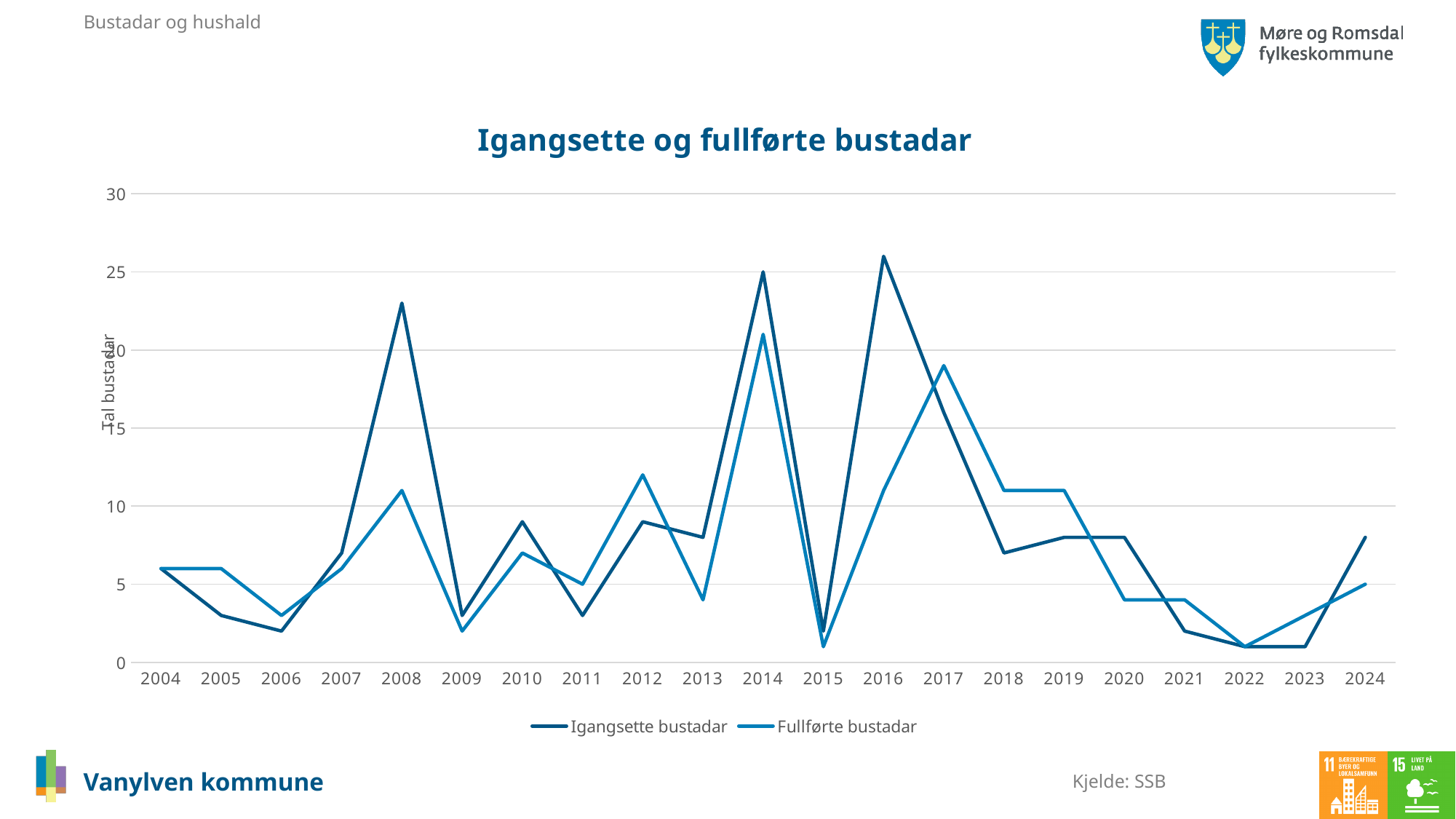
How many years are shown on the x axis? 21 How many series does the legend list? 2 What is the value for Fullførte bustadar in 2024? 5 In which year is Igangsette bustadar highest? 2016 Does Fullførte bustadar rise or fall from 2017 to 2022? Fall What is the value for Igangsette bustadar in 2014? 25 Is the value for Igangsette bustadar in 2008 greater or less than 20? greater Is the value for Fullførte bustadar in 2017 greater or less than 20? less What kind of chart is shown on the slide? Line chart In 2017, which series has the larger value, Igangsette bustadar or Fullførte bustadar? Fullførte bustadar In which year is Fullførte bustadar highest? 2014 Is the value for Igangsette bustadar in 2021 greater or less than 5? less